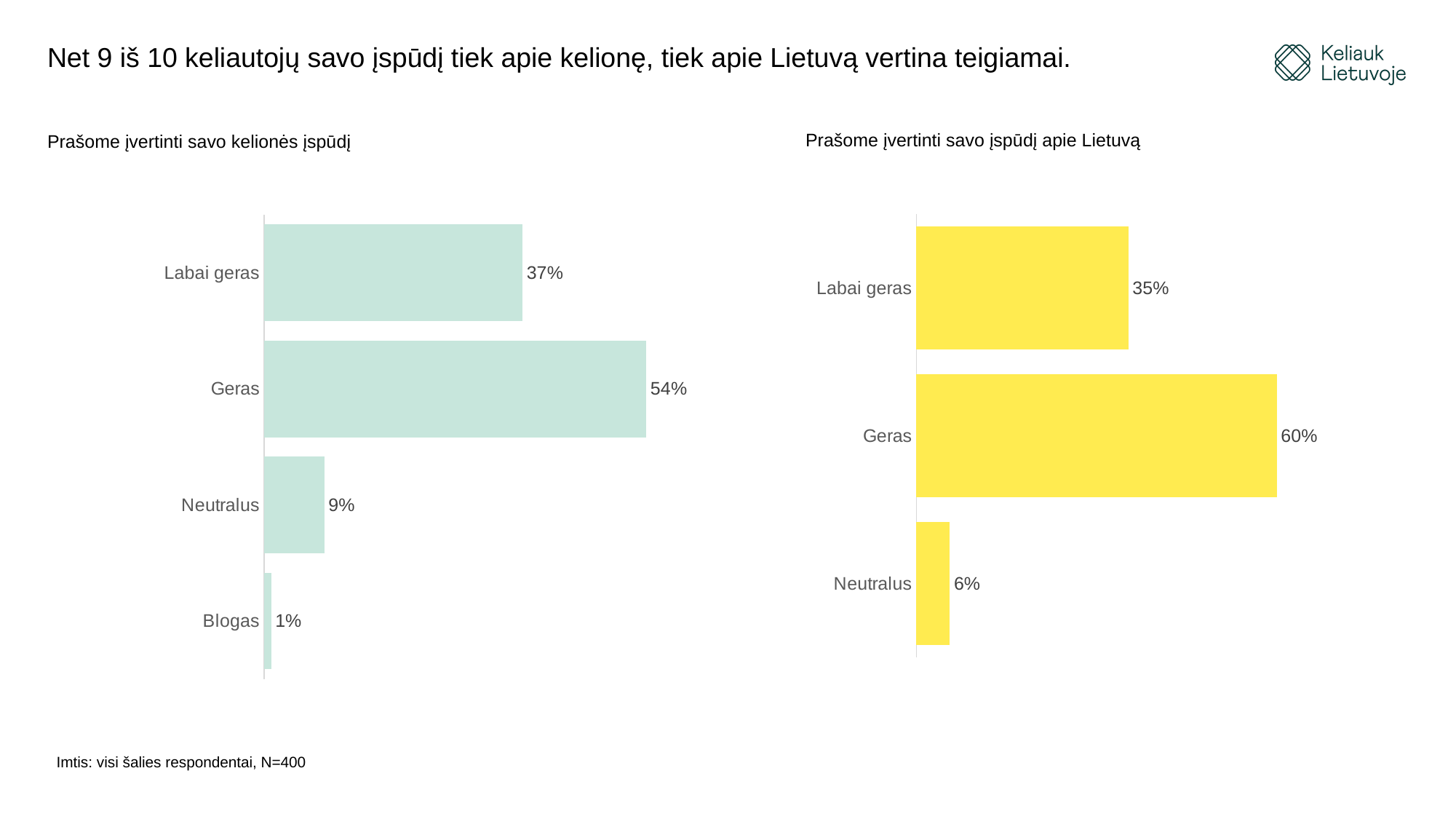
In the left chart (Prašome įvertinti savo kelionės įspūdį), what is the value for Blogas? 1% In the right chart (Prašome įvertinti savo įspūdį apie Lietuvą), what is the value for Labai geras? 35% In the left chart (Prašome įvertinti savo kelionės įspūdį), what is the difference between Geras and Labai geras? 17% Which is larger: Labai geras in the left chart or Labai geras in the right chart? Left chart (37%) What type of chart is used on the right side of the slide? Bar chart In the right chart (Prašome įvertinti savo įspūdį apie Lietuvą), what is the difference between Geras and Labai geras? 25% How many categories does the left chart (Prašome įvertinti savo kelionės įspūdį) show? 4 How many categories does the right chart (Prašome įvertinti savo įspūdį apie Lietuvą) show? 3 In the left chart (Prašome įvertinti savo kelionės įspūdį), which category has the highest value? Geras In the left chart (Prašome įvertinti savo kelionės įspūdį), what is the value for Geras? 54% In the right chart (Prašome įvertinti savo įspūdį apie Lietuvą), which category has the lowest value? Neutralus In the right chart (Prašome įvertinti savo įspūdį apie Lietuvą), what is the value for Neutralus? 6%